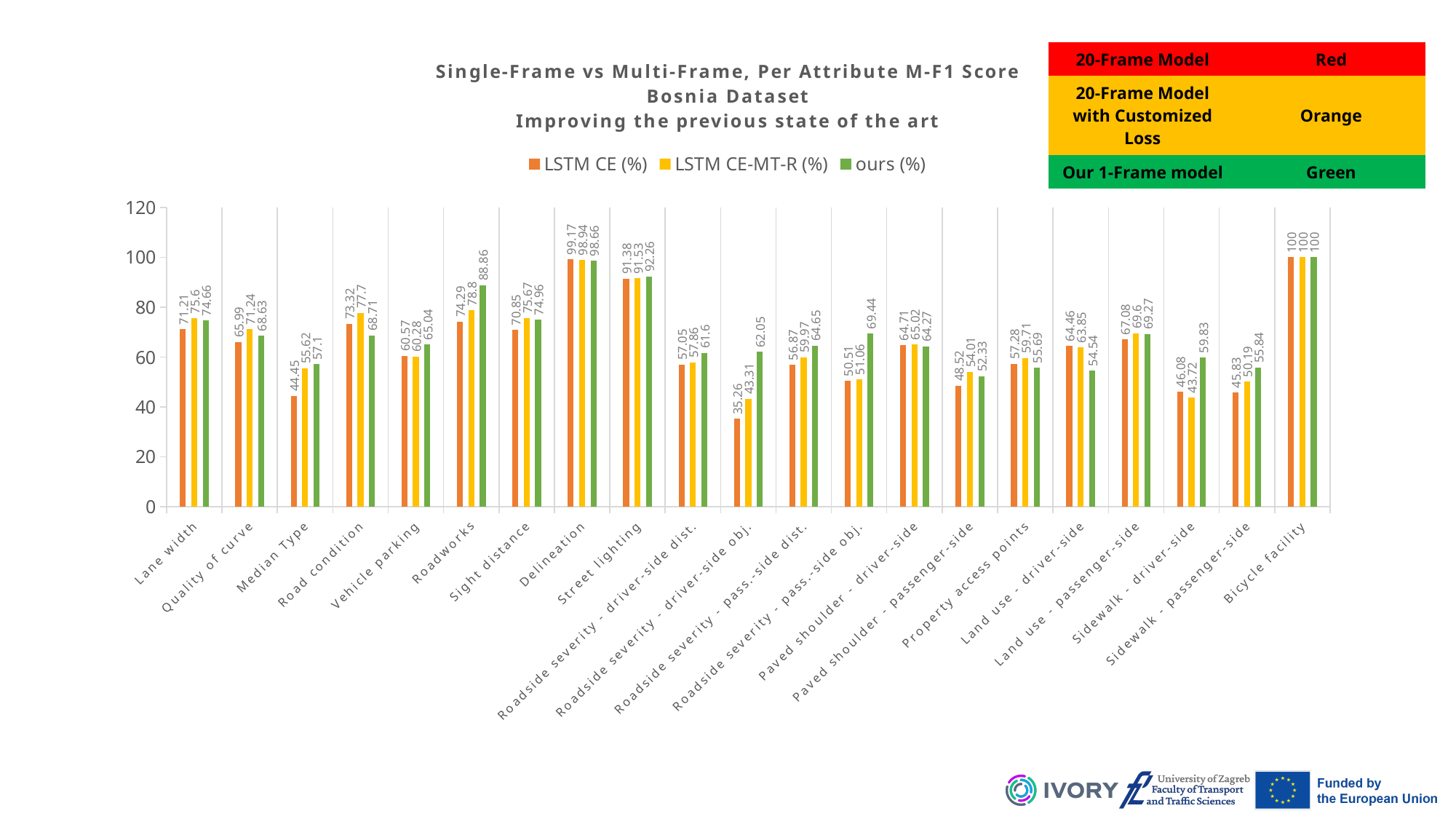
What is the LSTM CE (%) value for Roadside severity - driver-side obj.? 35.26 What is the LSTM CE-MT-R (%) value for Median Type? 55.62 What is the difference between the ours (%) value and the LSTM CE (%) value for Roadside severity - pass.-side obj.? 18.93 For Road condition, which is larger: the LSTM CE-MT-R (%) value or the ours (%) value? LSTM CE-MT-R (%) How many series does the legend list? 3 What is the value of ours (%) for Roadworks? 88.86 According to the colour key on the slide, which colour represents the 1-Frame model? Green How many categories are shown on the x axis? 21 What kind of chart is shown on the slide? Bar chart Is the ours (%) value for Sidewalk - driver-side greater or less than 40? greater Which category has the highest ours (%) value? Bicycle facility Which category has the lowest LSTM CE (%) value? Roadside severity - driver-side obj.